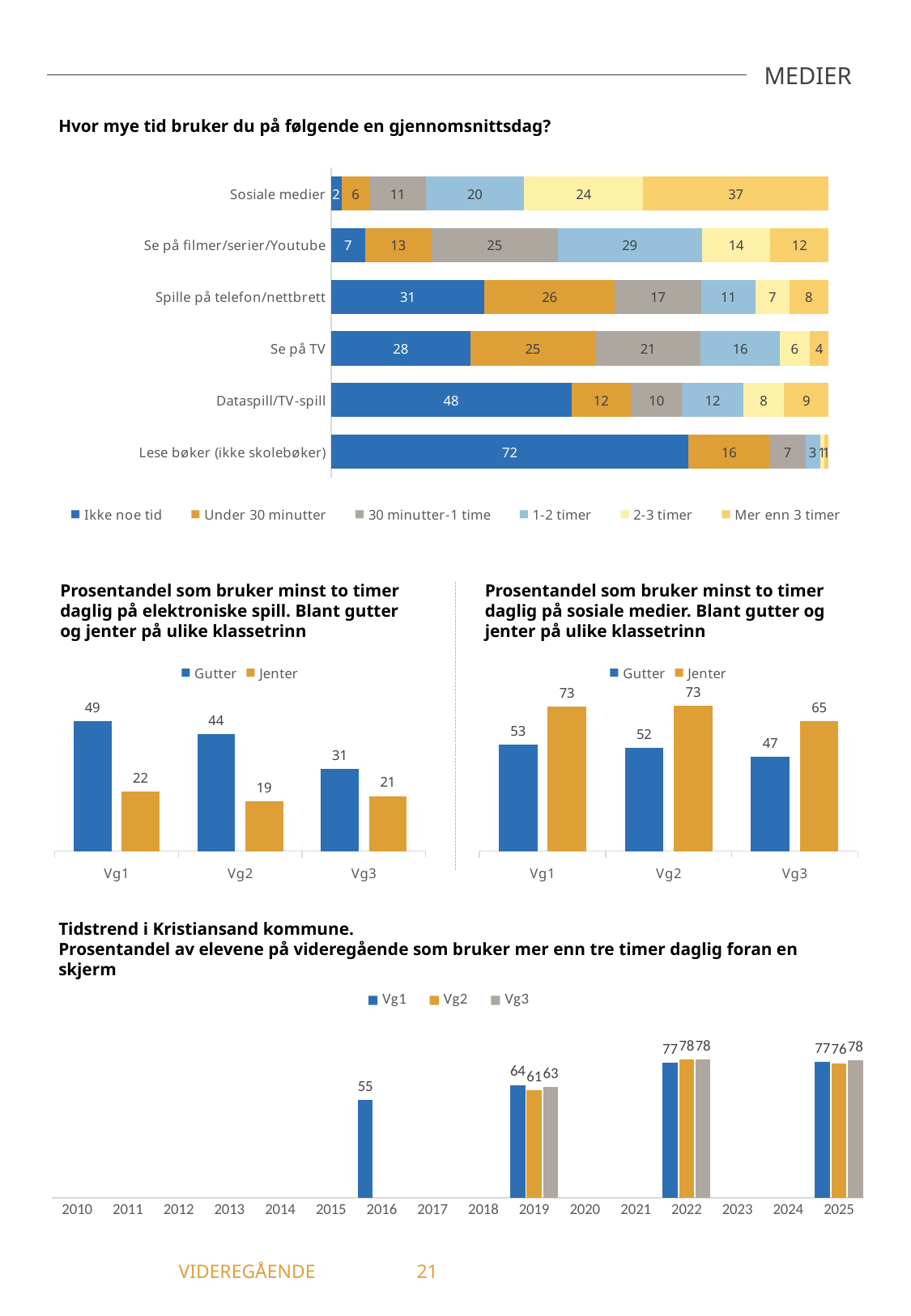
In the chart 'Prosentandel som bruker minst to timer daglig på elektroniske spill', what is the value for Gutter at Vg1? 49 In the chart 'Tidstrend i Kristiansand kommune', do the Vg1 values rise or fall from 2016 to 2022? rise In the chart 'Prosentandel som bruker minst to timer daglig på elektroniske spill', which class level has the lowest value for Jenter? Vg2 In the chart 'Prosentandel som bruker minst to timer daglig på sosiale medier', what is the value for Jenter at Vg3? 65 In the chart 'Hvor mye tid bruker du på følgende en gjennomsnittsdag?', what is the value for 'Mer enn 3 timer' for Sosiale medier? 37 In the chart 'Hvor mye tid bruker du på følgende en gjennomsnittsdag?', what is the value for 'Ikke noe tid' for Lese bøker (ikke skolebøker)? 72 In the chart 'Tidstrend i Kristiansand kommune', what is the value for Vg1 in 2016? 55 In the chart 'Hvor mye tid bruker du på følgende en gjennomsnittsdag?', what is the difference between the '1-2 timer' values for Se på filmer/serier/Youtube and Sosiale medier? 9 In the chart 'Hvor mye tid bruker du på følgende en gjennomsnittsdag?', how many series does the legend list? 6 In the chart 'Hvor mye tid bruker du på følgende en gjennomsnittsdag?', which category has the highest 'Ikke noe tid' value? Lese bøker (ikke skolebøker) In the chart 'Prosentandel som bruker minst to timer daglig på sosiale medier', which is larger at Vg1, Gutter or Jenter? Jenter In the chart 'Prosentandel som bruker minst to timer daglig på sosiale medier', what is the difference between Jenter and Gutter at Vg2? 21